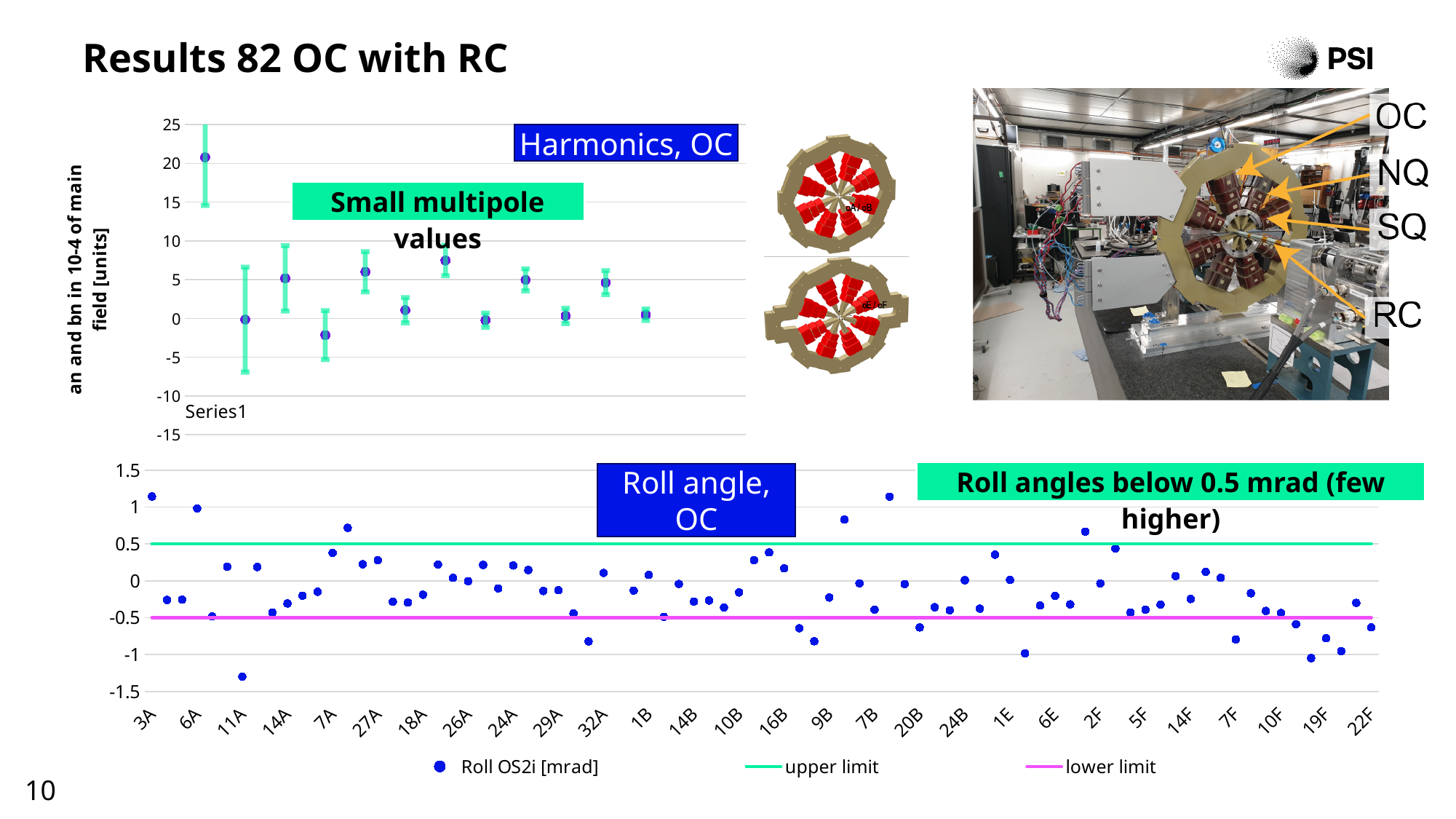
How many data points are plotted in the 'Harmonics, OC' chart? 12 What is the first category label on the x axis of the 'Roll angle, OC' chart? 3A How many series does the legend of the 'Roll angle, OC' chart list? 3 In the 'Harmonics, OC' chart, is the value of the highest point greater or less than 15? greater What is the y-axis label of the 'Harmonics, OC' chart? an and bn in 10-4 of main field [units] What kind of chart is the 'Harmonics, OC' chart? scatter chart In the 'Roll angle, OC' chart, which is larger, the upper limit or the lower limit? upper limit In the 'Roll angle, OC' chart, at what value is the upper limit line drawn? 0.5 In the 'Roll angle, OC' chart, is the value for 3A greater or less than 1? greater What colour is the upper limit line in the 'Roll angle, OC' chart? green In the 'Harmonics, OC' chart, is the value of the lowest point greater or less than 0? less In the 'Roll angle, OC' chart, at what value is the lower limit line drawn? -0.5